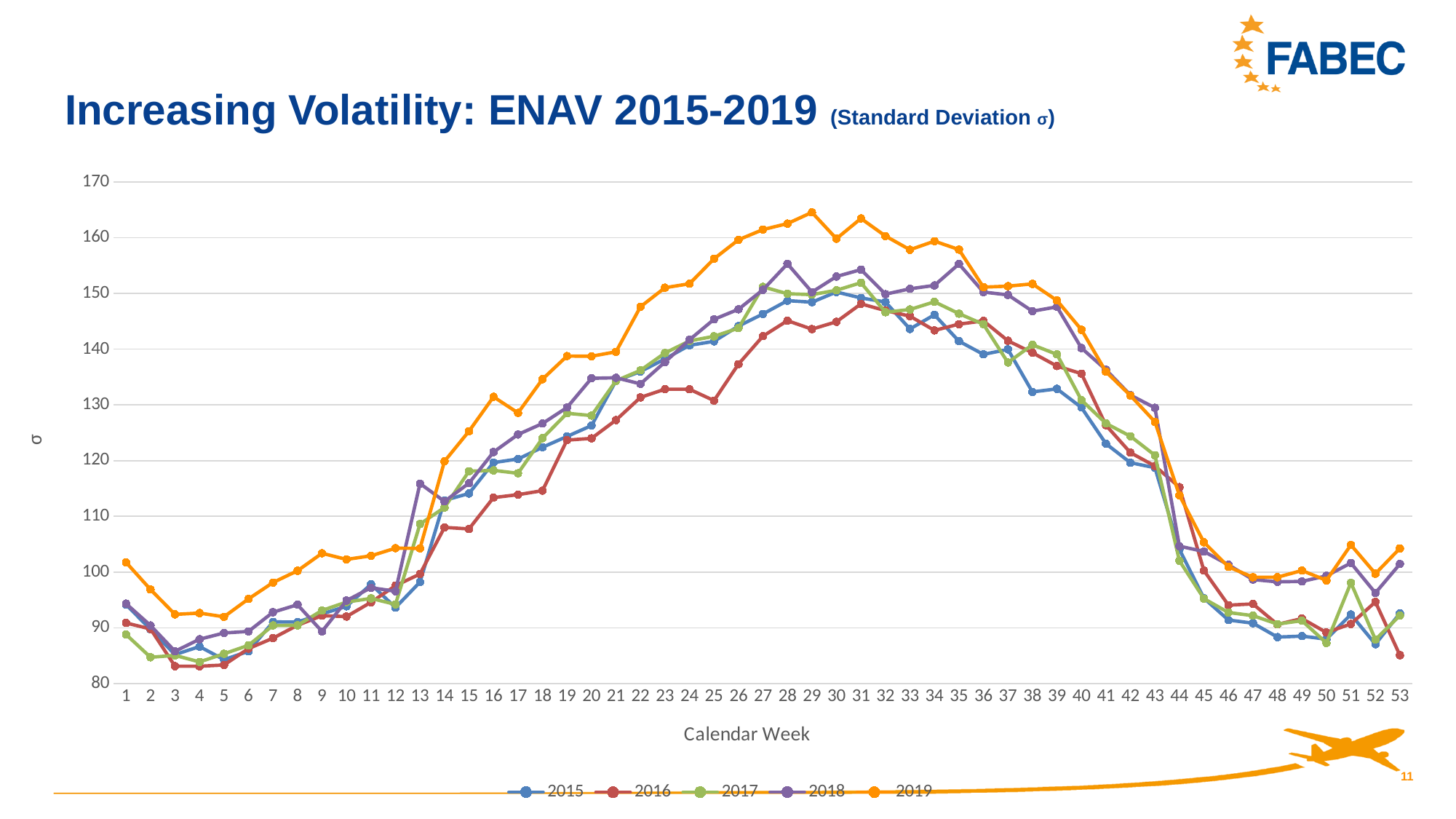
How many calendar weeks are plotted along the x axis? 53 Does the 2019 series rise or fall from calendar week 35 to calendar week 45? fall How many series does the legend list? 5 At calendar week 13, which series has the higher value, 2018 or 2016? 2018 What is the title of the x axis? Calendar Week Is the value for 2019 at calendar week 29 greater or less than 160? greater At calendar week 29, which series has the higher value, 2019 or 2016? 2019 Is the value for 2015 at calendar week 38 greater or less than 140? less Is the value for 2016 at calendar week 53 greater or less than 90? less Which series has the highest value at calendar week 29? 2019 What kind of chart is shown on the slide? line chart Which series has the lowest value at calendar week 53? 2016